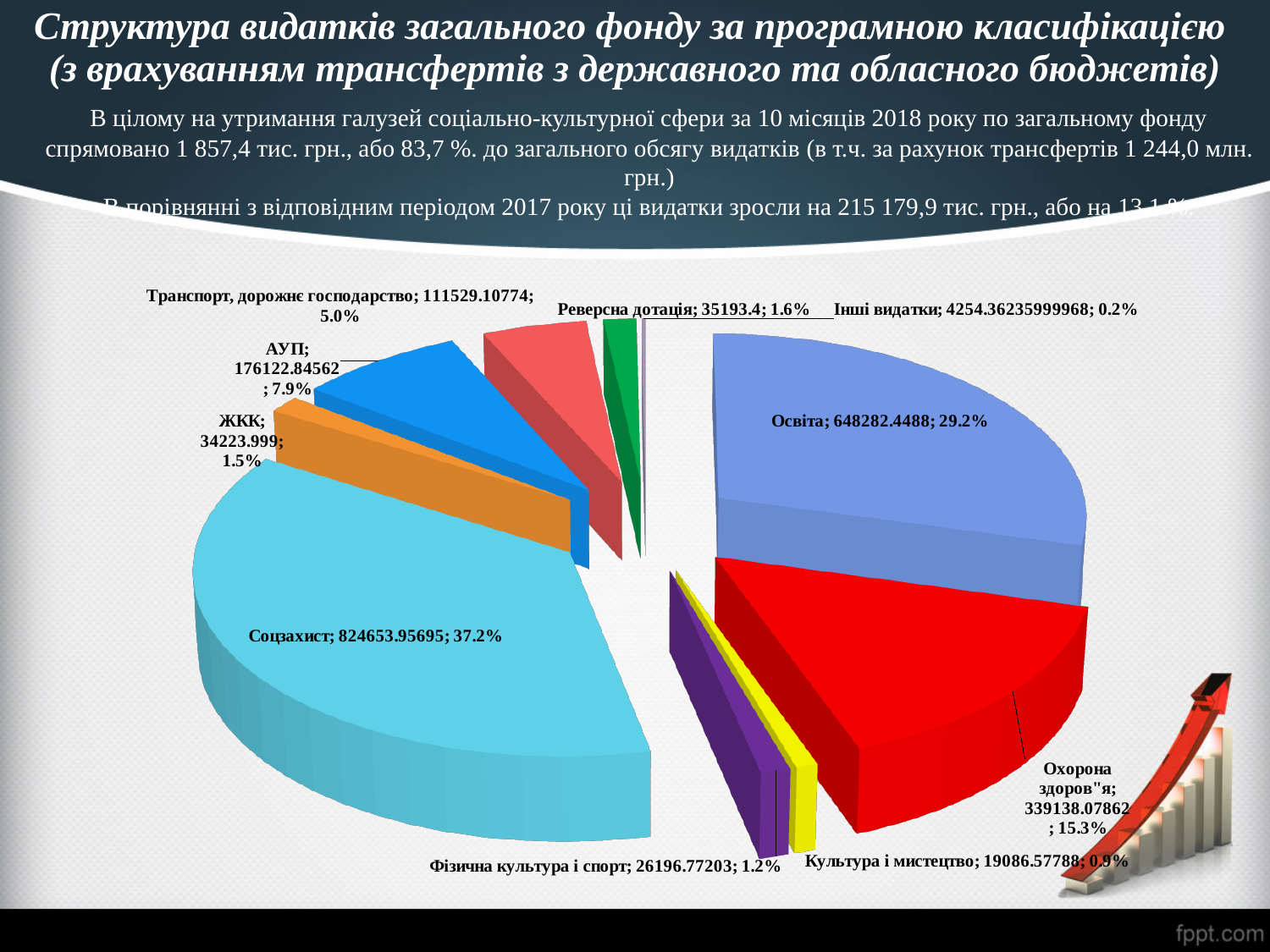
Which is larger, the share for Транспорт, дорожнє господарство or the share for ЖКК? Транспорт, дорожнє господарство What is the difference in percentage points between the shares of Соцзахист and Освіта? 8.0% Which category has the largest slice of the pie? Соцзахист What is the value shown for Культура і мистецтво? 19086.57788 What is the value shown for Реверсна дотація? 35193.4 How many slices does the pie chart have? 10 What is the value shown for Освіта? 648282.4488 Which category has the smallest slice of the pie? Інші видатки What share of the pie does АУП represent? 7.9% What is the value shown for Соцзахист? 824653.95695 What share of the pie does Охорона здоров"я represent? 15.3% What kind of chart is shown on the slide? pie chart